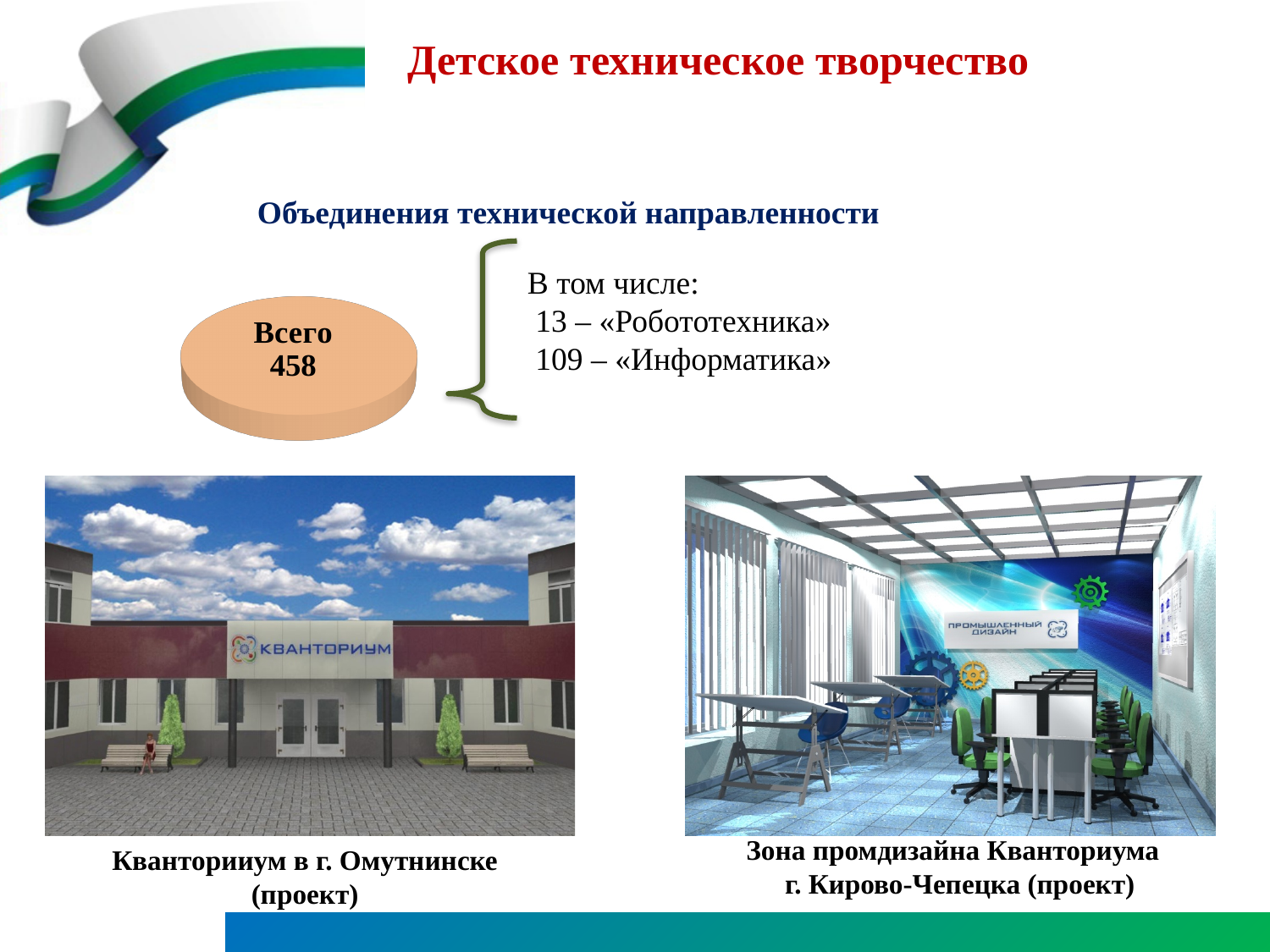
How many slices does the pie chart contain? 1 What total value is shown on the pie chart under the heading "Объединения технической направленности"? 458 What kind of chart is shown next to the text "В том числе"? pie chart Is the total value shown on the pie chart greater or less than 400? greater What is the heading above the pie chart? Объединения технической направленности What label is printed on the pie chart? Всего 458